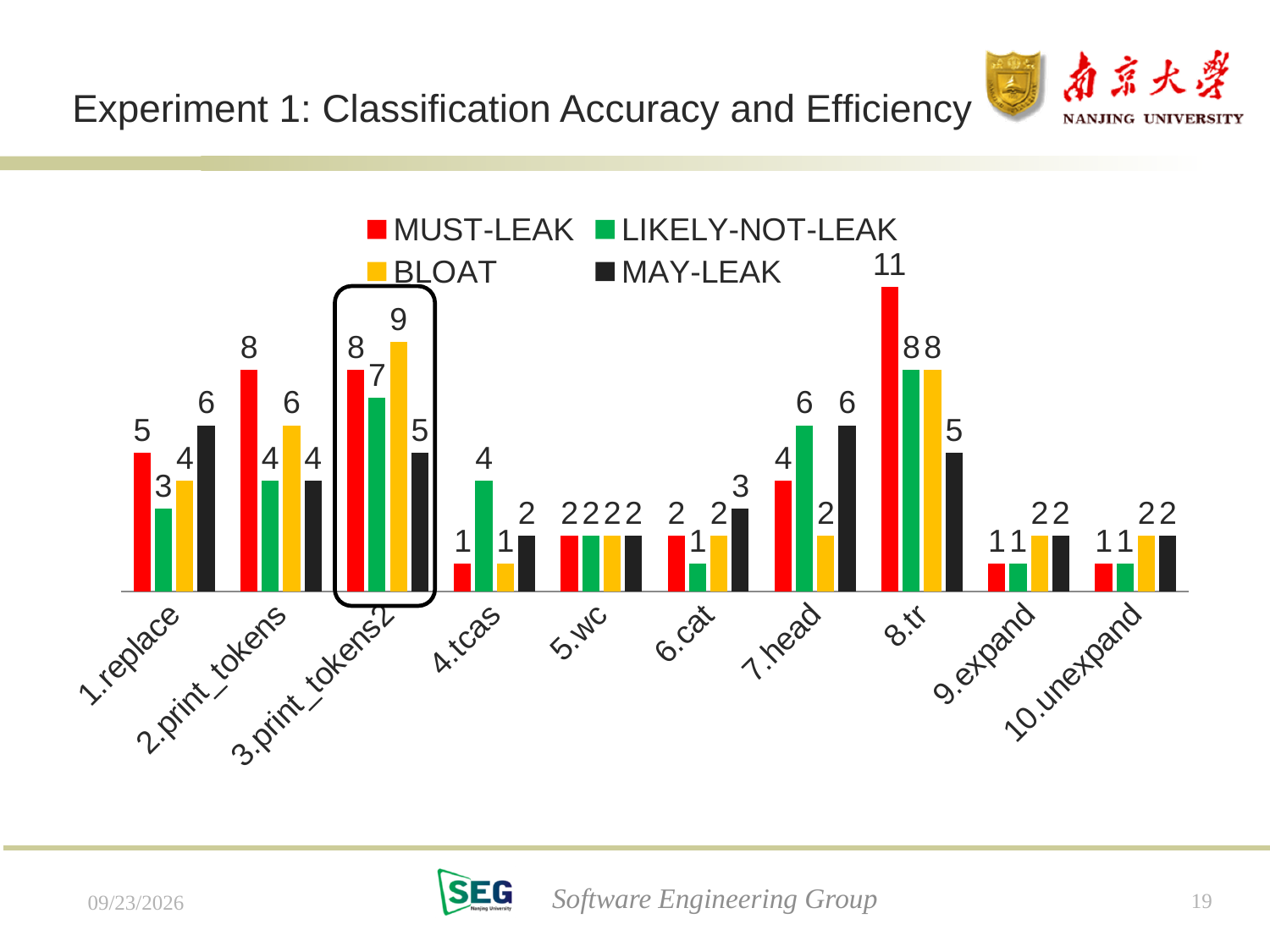
What is the MUST-LEAK value for 8.tr? 11 Which category is outlined with a black rounded box? 3.print_tokens2 How many categories are shown on the x axis? 10 What kind of chart is shown on the slide? Bar chart How many series does the legend list? 4 Which category has the lowest LIKELY-NOT-LEAK value? 6.cat, 9.expand and 10.unexpand (tied at 1) For 2.print_tokens, which is larger: the MUST-LEAK value or the BLOAT value? MUST-LEAK What is the BLOAT value for 3.print_tokens2? 9 What is the LIKELY-NOT-LEAK value for 7.head? 6 What is the MAY-LEAK value for 1.replace? 6 Which category has the highest MUST-LEAK value? 8.tr What is the difference between the MUST-LEAK and MAY-LEAK values for 8.tr? 6